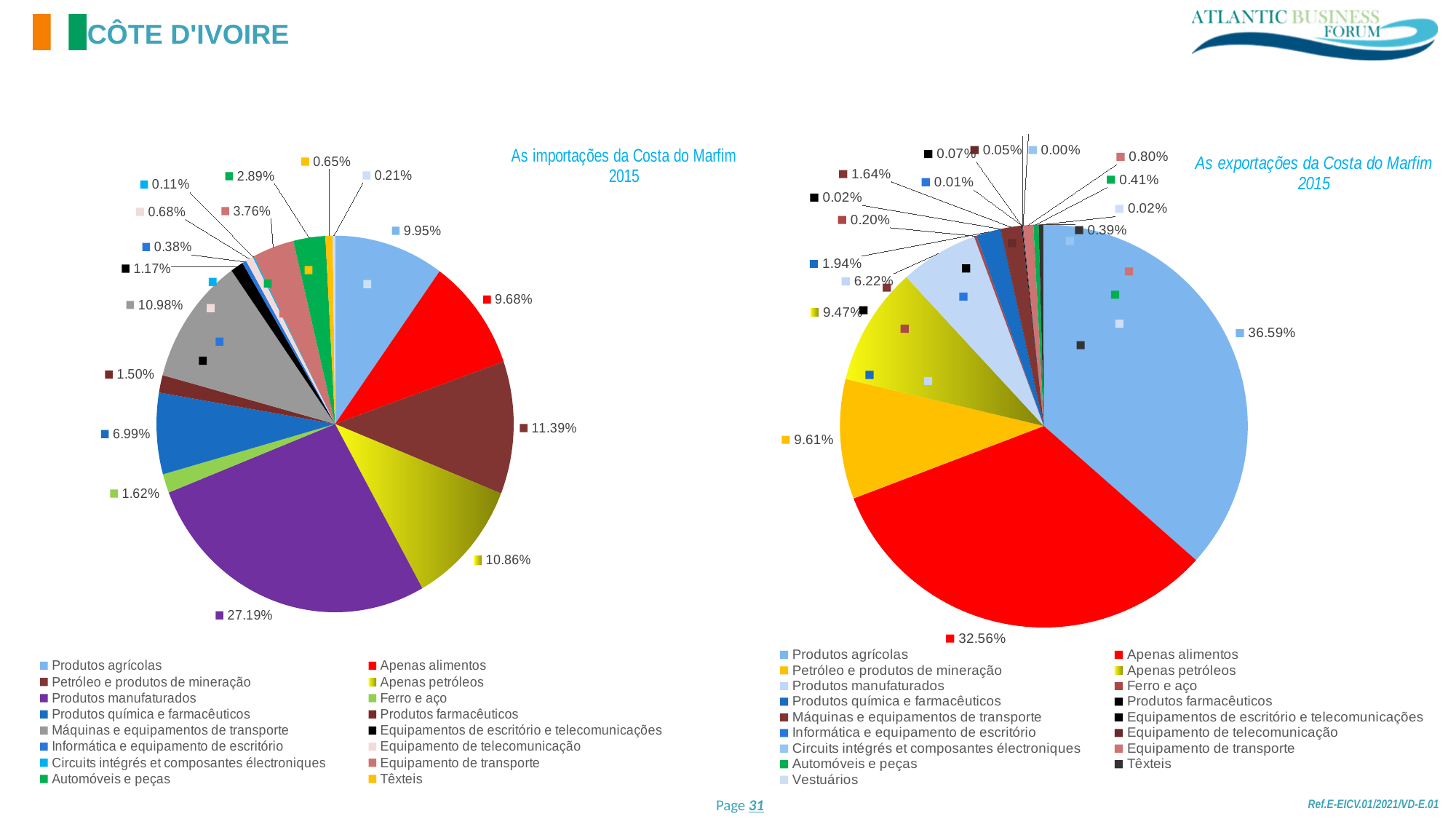
In the 'As importações da Costa do Marfim 2015' pie chart, which is larger: Máquinas e equipamentos de transporte or Produtos química e farmacêuticos? Máquinas e equipamentos de transporte How many entries does the legend of the 'As exportações da Costa do Marfim 2015' chart list? 17 In the 'As importações da Costa do Marfim 2015' pie chart, what share is shown for Petróleo e produtos de mineração? 11.39% In the 'As exportações da Costa do Marfim 2015' pie chart, which is larger: Petróleo e produtos de mineração or Produtos manufaturados? Petróleo e produtos de mineração In the 'As importações da Costa do Marfim 2015' pie chart, what share is shown for Produtos manufaturados? 27.19% In the 'As exportações da Costa do Marfim 2015' pie chart, what share is shown for Produtos agrícolas? 36.59% In the 'As importações da Costa do Marfim 2015' pie chart, which category has the largest slice? Produtos manufaturados In the 'As exportações da Costa do Marfim 2015' pie chart, what share is shown for Apenas alimentos? 32.56% In the 'As importações da Costa do Marfim 2015' pie chart, what is the difference between the shares of Produtos agrícolas and Apenas alimentos? 0.27% In the 'As exportações da Costa do Marfim 2015' pie chart, what is the difference between the shares of Produtos agrícolas and Apenas alimentos? 4.03% What type of chart is used for 'As exportações da Costa do Marfim 2015'? Pie chart In the 'As exportações da Costa do Marfim 2015' pie chart, which category has the largest slice? Produtos agrícolas